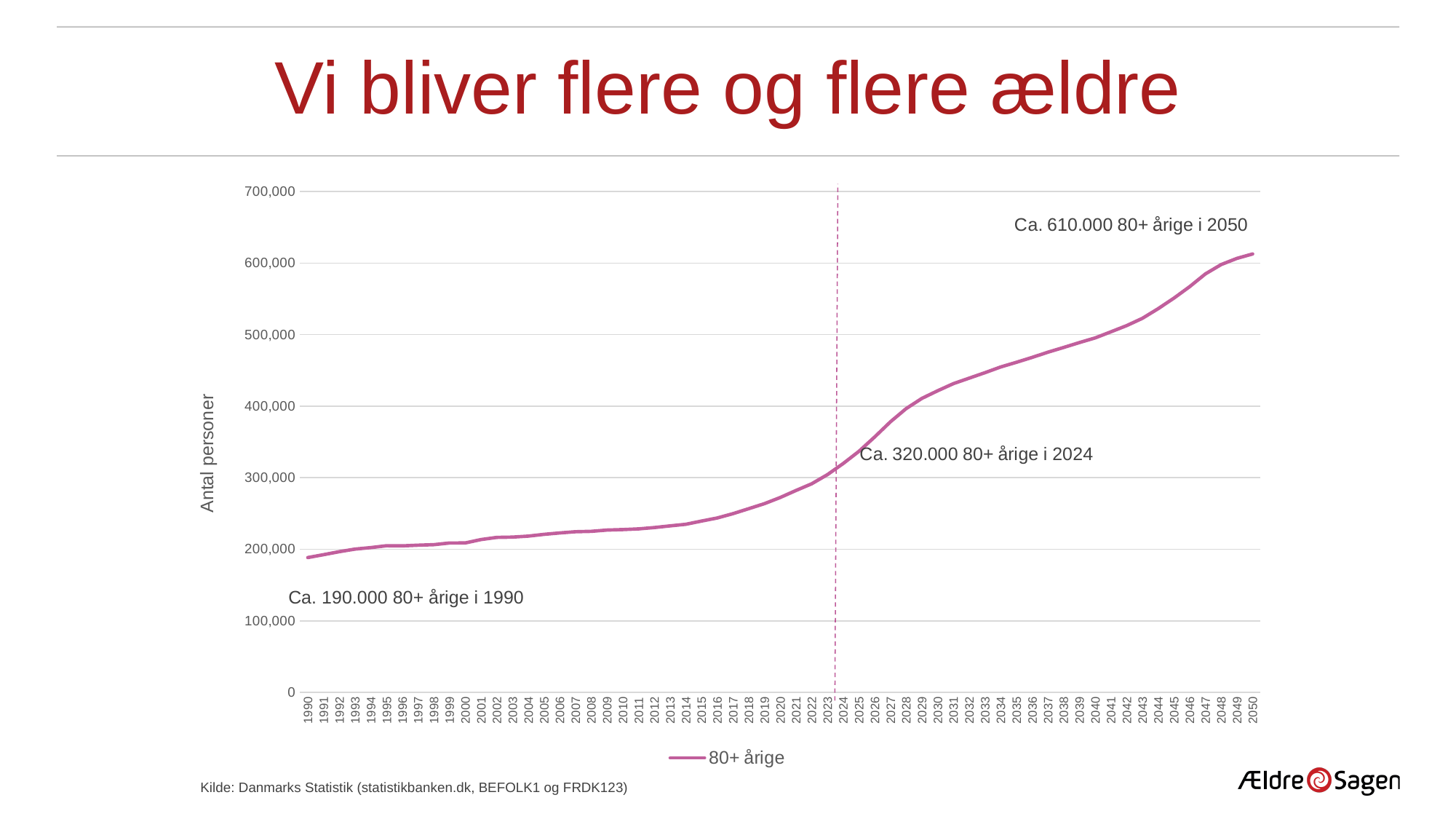
What kind of chart is shown on the slide? line chart Do the values rise or fall from 1990 to 2050? rise Is the value for 2035 greater or less than 500,000? less What is the name of the series shown in the legend? 80+ årige How many series does the legend list? 1 Is the value for 2050 greater or less than 600,000? greater Which year has the highest value for 80+ årige? 2050 What is the label on the vertical axis? Antal personer Is the value for 1990 greater or less than 200,000? less Which year has the lowest value for 80+ årige? 1990 Which year has the larger value, 2010 or 2030? 2030